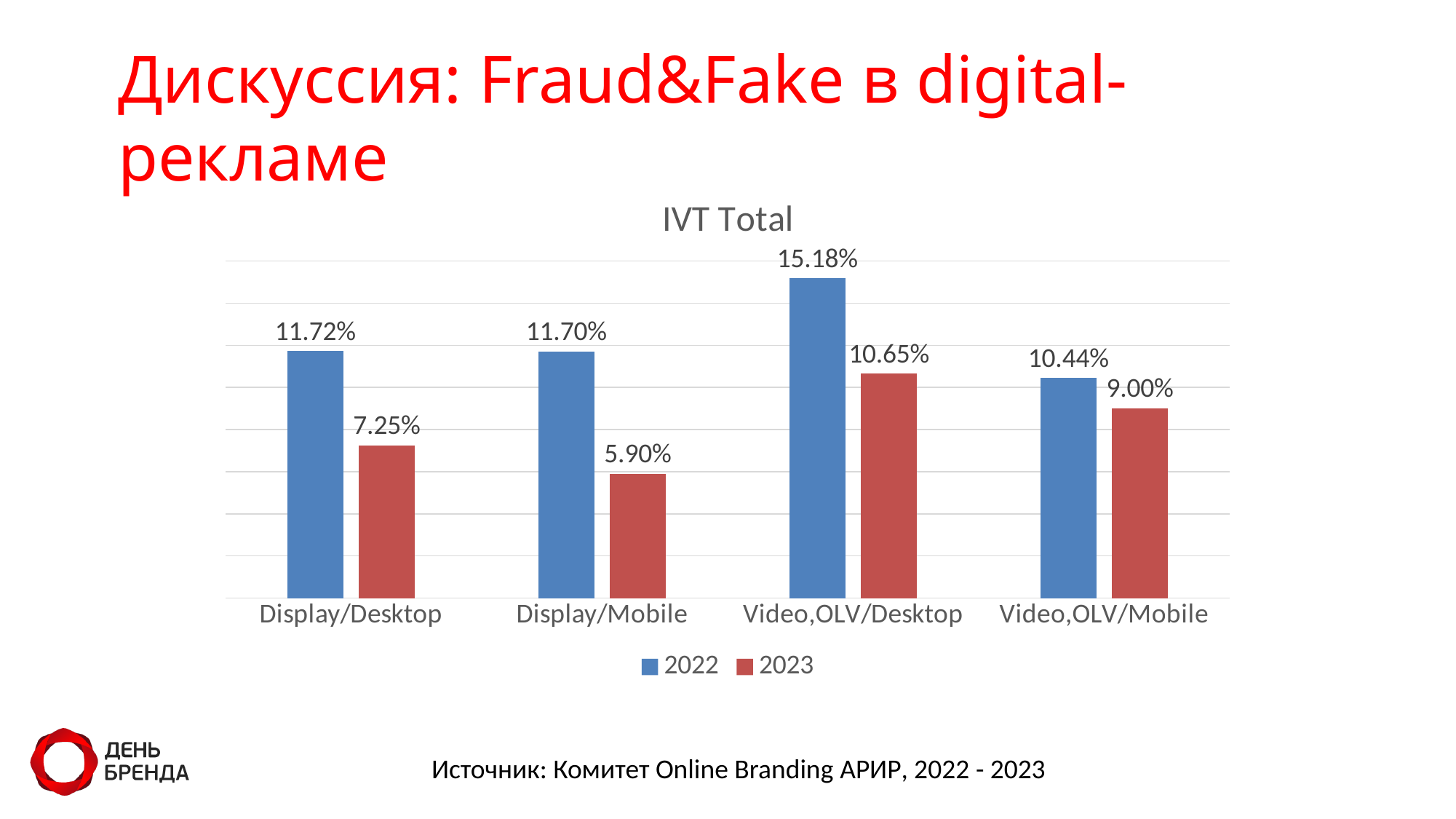
Which category has the lowest 2023 value? Display/Mobile How many series does the legend list? 2 What is the 2023 value for Video,OLV/Desktop? 10.65% What is the 2022 value for Display/Desktop? 11.72% Which category has the highest 2022 value? Video,OLV/Desktop What is the 2022 value for Video,OLV/Mobile? 10.44% What kind of chart is shown on the slide? Bar chart What is the difference between the 2022 and 2023 values for Display/Desktop? 4.47% What is the title of the chart? IVT Total What is the 2023 value for Display/Mobile? 5.90% Which is larger: the 2023 value for Video,OLV/Desktop or the 2023 value for Video,OLV/Mobile? Video,OLV/Desktop How many categories are shown on the x axis? 4